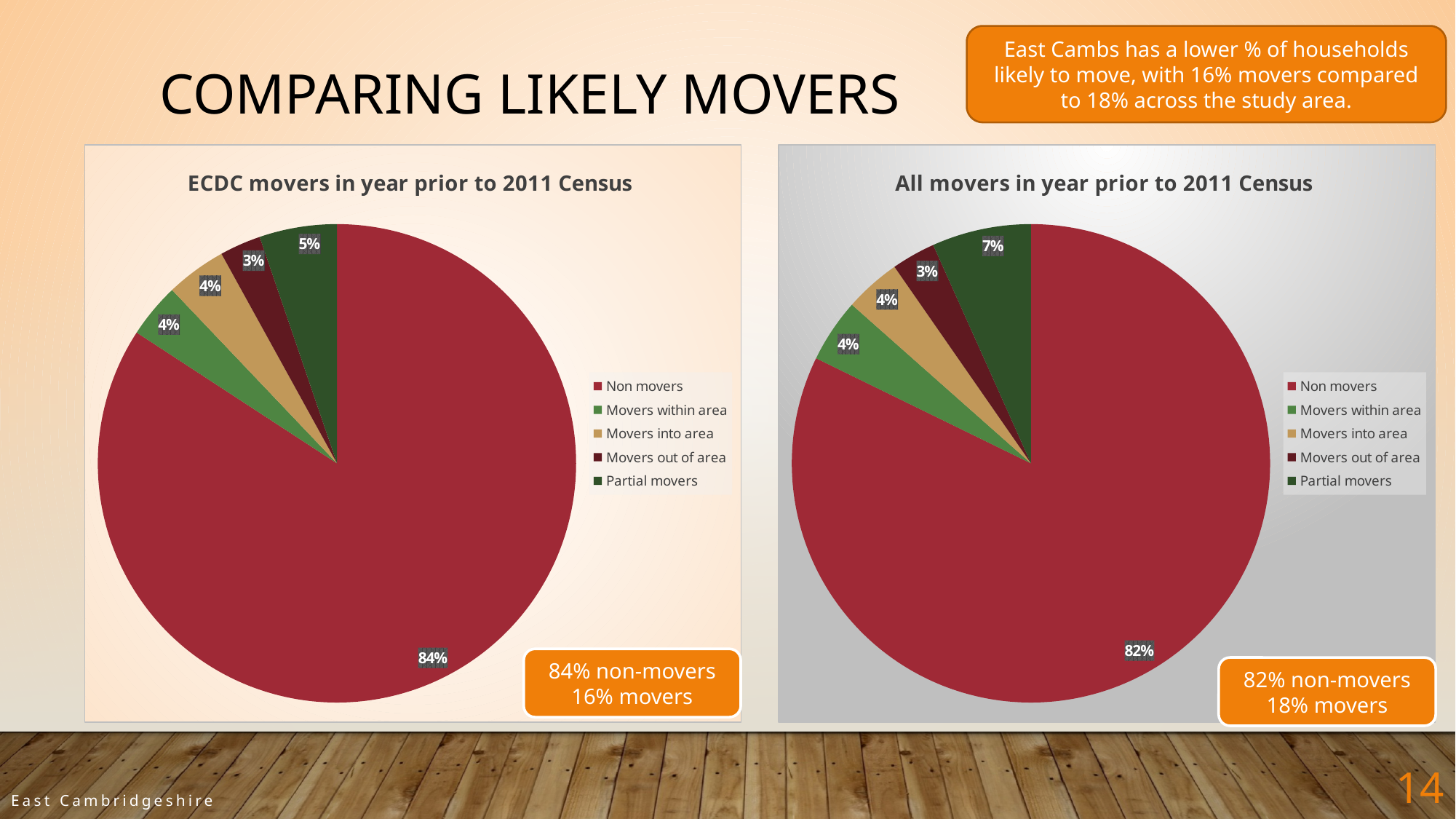
In the chart titled 'ECDC movers in year prior to 2011 Census', what percentage is shown for Non movers? 84% In the chart titled 'All movers in year prior to 2011 Census', what colour is the Non movers slice? Red In the chart titled 'ECDC movers in year prior to 2011 Census', what percentage is shown for Movers out of area? 3% In the chart titled 'All movers in year prior to 2011 Census', what percentage is shown for Partial movers? 7% In the chart titled 'All movers in year prior to 2011 Census', which category has the smallest slice? Movers out of area What type of chart is the 'ECDC movers in year prior to 2011 Census' chart? Pie chart How many categories does the legend list in the chart titled 'All movers in year prior to 2011 Census'? 5 In the chart titled 'ECDC movers in year prior to 2011 Census', which category has the largest slice? Non movers In the chart titled 'ECDC movers in year prior to 2011 Census', what share of the pie do Movers within area represent? 4% In the chart titled 'ECDC movers in year prior to 2011 Census', which is larger: Partial movers or Movers out of area? Partial movers In the chart titled 'All movers in year prior to 2011 Census', what percentage is shown for Non movers? 82% What is the difference between the Partial movers percentage in the 'All movers in year prior to 2011 Census' chart and the Partial movers percentage in the 'ECDC movers in year prior to 2011 Census' chart? 2%